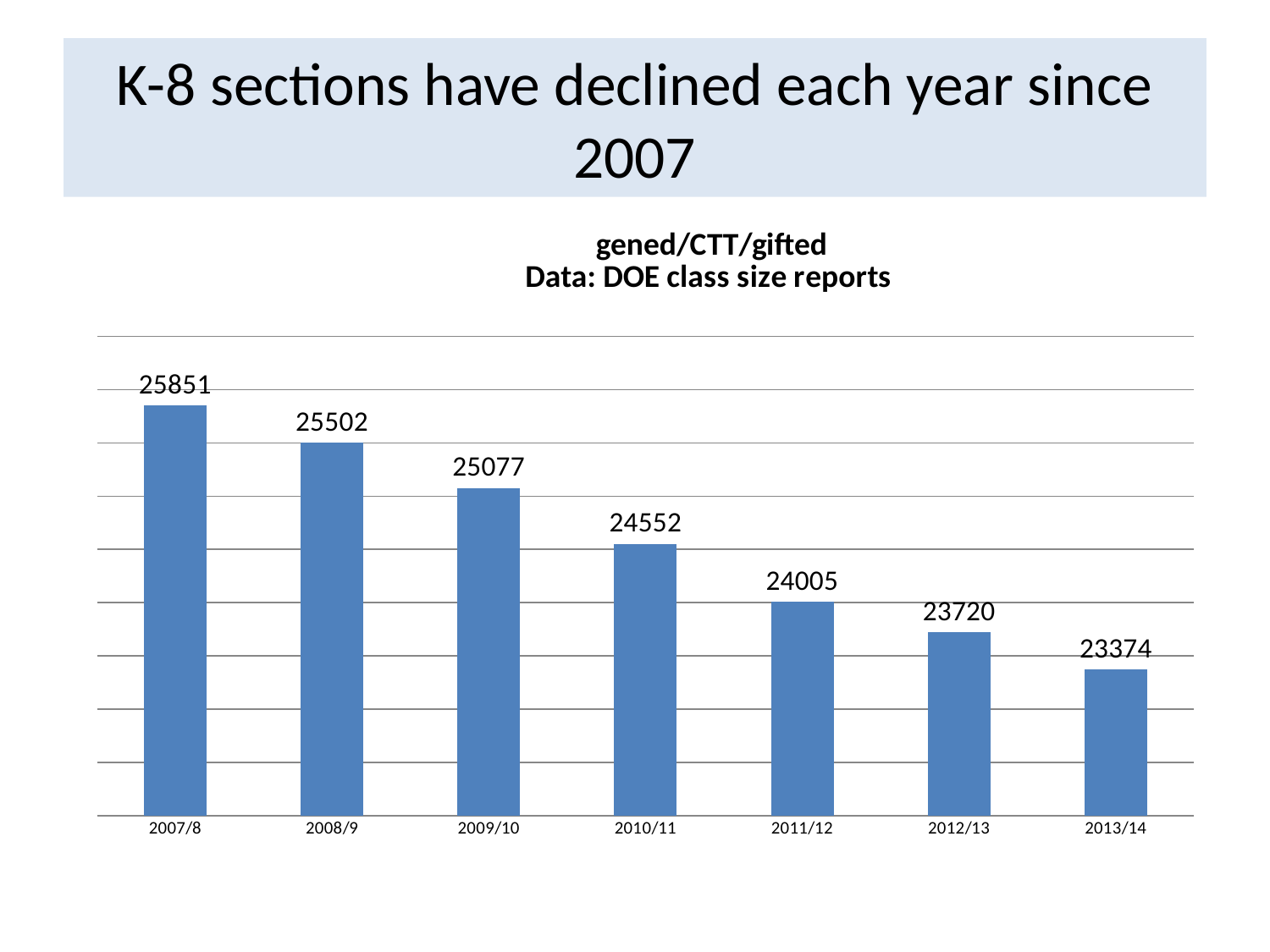
What is the value for 2013/14? 23374 Do the values rise or fall from 2007/8 to 2013/14? fall Which year has the lowest value? 2013/14 What is the title of the chart? gened/CTT/gifted Data: DOE class size reports Which year has the highest value? 2007/8 What is the difference between the values for 2011/12 and 2012/13? 285 What kind of chart is shown? bar chart How many years are shown on the chart? 7 Which is larger, the value for 2008/9 or the value for 2009/10? 2008/9 What is the difference between the values for 2007/8 and 2013/14? 2477 What is the value for 2007/8? 25851 What is the value for 2010/11? 24552